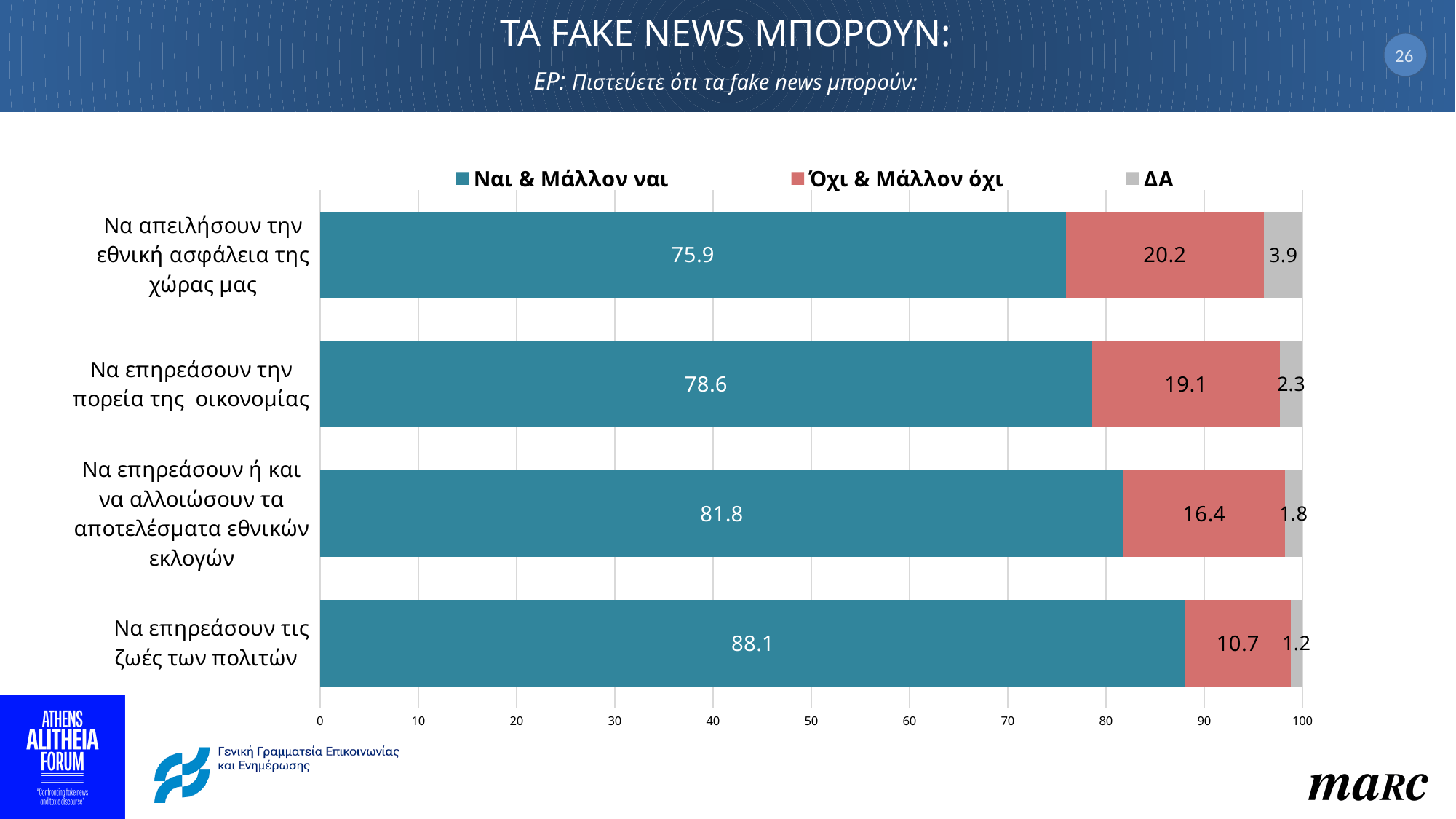
What is the total of the stacked bar for 'Να επηρεάσουν ή και να αλλοιώσουν τα αποτελέσματα εθνικών εκλογών'? 100 Which is larger: the 'Όχι & Μάλλον όχι' value for 'Να επηρεάσουν την πορεία της οικονομίας' or for 'Να επηρεάσουν ή και να αλλοιώσουν τα αποτελέσματα εθνικών εκλογών'? Να επηρεάσουν την πορεία της οικονομίας What colour represents the 'ΔΑ' series in the chart? grey What is the value of 'Όχι & Μάλλον όχι' for 'Να απειλήσουν την εθνική ασφάλεια της χώρας μας'? 20.2 Which category has the highest value for 'Ναι & Μάλλον ναι'? Να επηρεάσουν τις ζωές των πολιτών What is the difference between the 'Ναι & Μάλλον ναι' values for 'Να επηρεάσουν τις ζωές των πολιτών' and 'Να επηρεάσουν την πορεία της οικονομίας'? 9.5 What is the value of 'Ναι & Μάλλον ναι' for 'Να επηρεάσουν τις ζωές των πολιτών'? 88.1 How many series does the legend list? 3 Which category has the lowest value for 'Ναι & Μάλλον ναι'? Να απειλήσουν την εθνική ασφάλεια της χώρας μας How many categories are shown on the chart? 4 What kind of chart is shown on the slide? stacked bar chart What is the value of 'ΔΑ' for 'Να επηρεάσουν την πορεία της οικονομίας'? 2.3